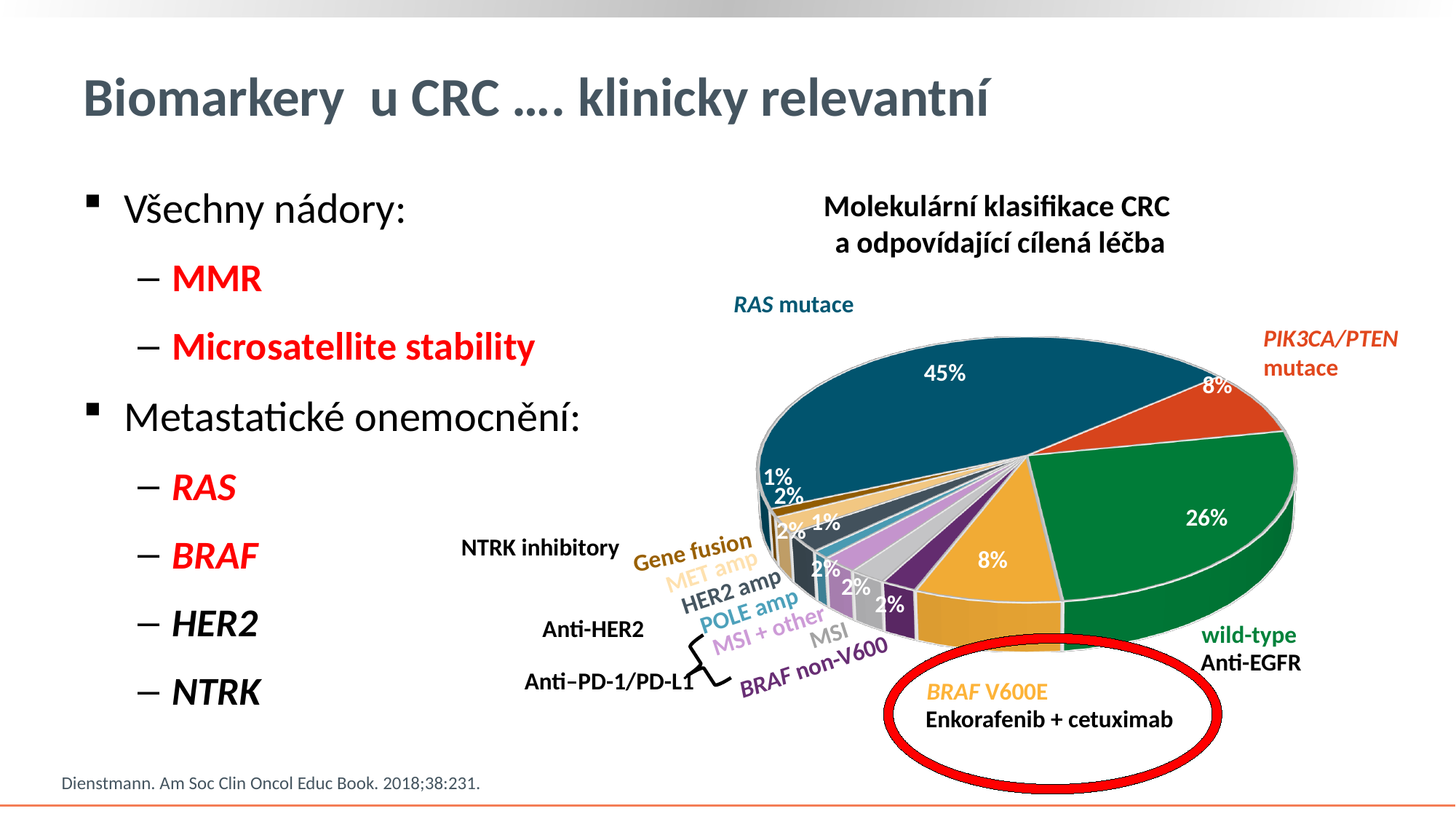
Which slice of the pie chart is the largest? RAS mutace What is the difference in percentage points between the RAS mutace slice (45%) and the wild-type slice (26%)? 19 percentage points Which slice label is circled in red on the slide? BRAF V600E (Enkorafenib + cetuximab) What is the combined percentage of the RAS mutace and wild-type slices? 71% What percentage is shown for the PIK3CA/PTEN mutace slice? 8% Which is larger, the RAS mutace slice or the wild-type slice? RAS mutace How many slices does the pie chart have? 11 What percentage does the wild-type slice represent in the pie chart? 26% What percentage is shown for the BRAF V600E slice? 8% What kind of chart is shown on the slide? Pie chart What percentage of the pie chart is the RAS mutace slice? 45% What is the title of the pie chart? Molekulární klasifikace CRC a odpovídající cílená léčba